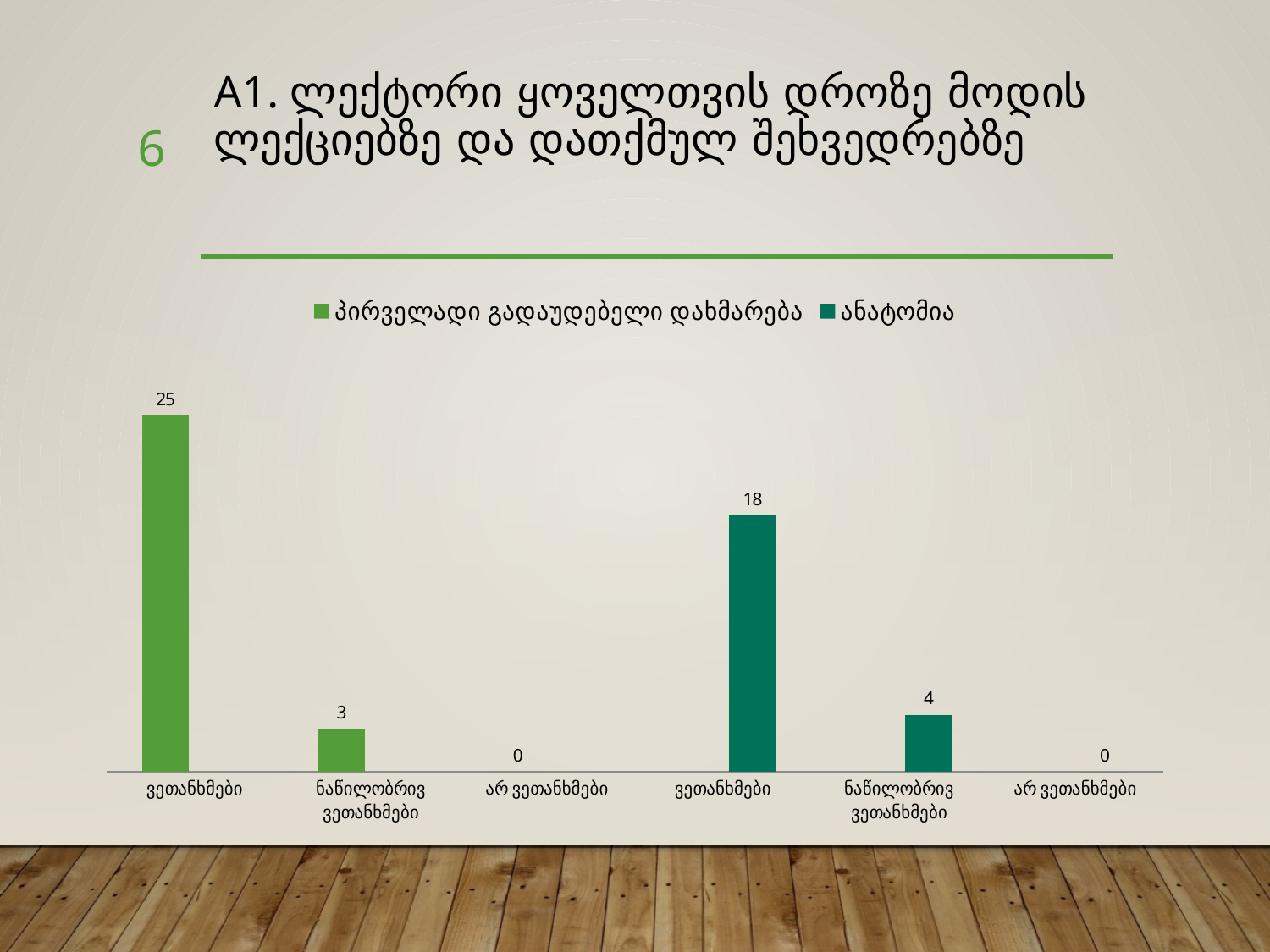
How many series does the legend list? 2 How many bars (category positions) are shown along the x axis? 6 Which bar has the highest value on the chart? ვეთანხმები (პირველადი გადაუდებელი დახმარება), 25 What is the value for ვეთანხმები in the პირველადი გადაუდებელი დახმარება series? 25 What is the difference between the ვეთანხმები values of the two series (25 and 18)? 7 Which is larger: ნაწილობრივ ვეთანხმები for პირველადი გადაუდებელი დახმარება or for ანატომია? ანატომია What is the value for ნაწილობრივ ვეთანხმები in the ანატომია series? 4 Which series is shown in the darker green colour? ანატომია What is the value for ვეთანხმები in the ანატომია series? 18 What kind of chart is shown on the slide? Bar chart What is the value for არ ვეთანხმები in the ანატომია series? 0 What is the value for ნაწილობრივ ვეთანხმები in the პირველადი გადაუდებელი დახმარება series? 3